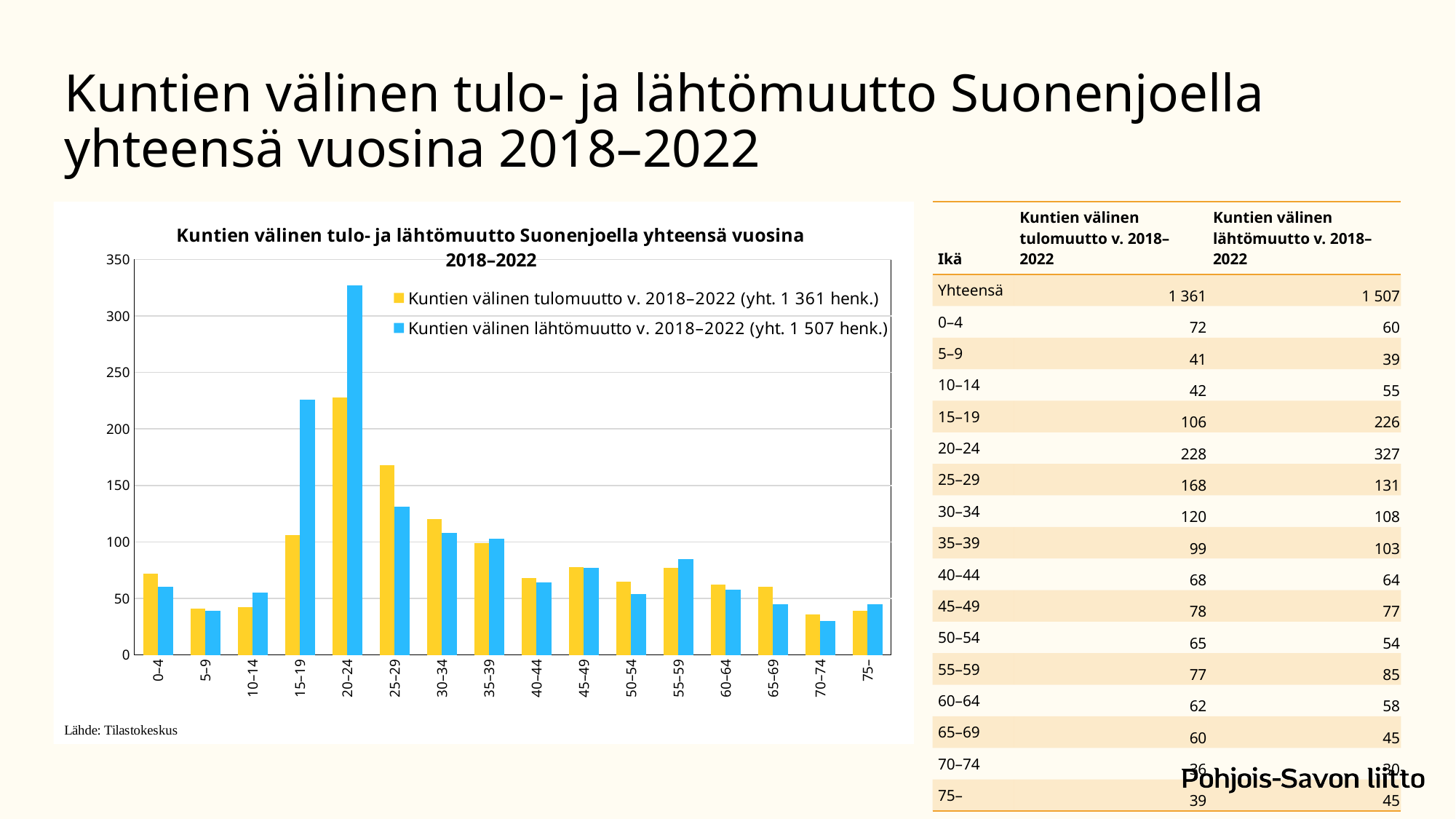
Which age group has the highest value for Kuntien välinen lähtömuutto v. 2018–2022? 20–24 What is the value of Kuntien välinen tulomuutto v. 2018–2022 for the 25–29 age group? 168 What is the value of Kuntien välinen lähtömuutto v. 2018–2022 for the 20–24 age group? 327 How many series does the chart legend list? 2 What is the total number of persons for Kuntien välinen tulomuutto v. 2018–2022 according to the legend? 1 361 henk. Which age group has the highest value for Kuntien välinen tulomuutto v. 2018–2022? 20–24 What kind of chart is shown on the slide? bar chart What is the difference between lähtömuutto and tulomuutto for the 20–24 age group? 99 How many age groups are shown on the x axis of the chart? 16 Which colour represents Kuntien välinen lähtömuutto v. 2018–2022 in the chart? blue Is the value of Kuntien välinen lähtömuutto v. 2018–2022 for the 15–19 age group greater or less than 200? greater For the 15–19 age group, which is larger: Kuntien välinen tulomuutto or Kuntien välinen lähtömuutto? Kuntien välinen lähtömuutto